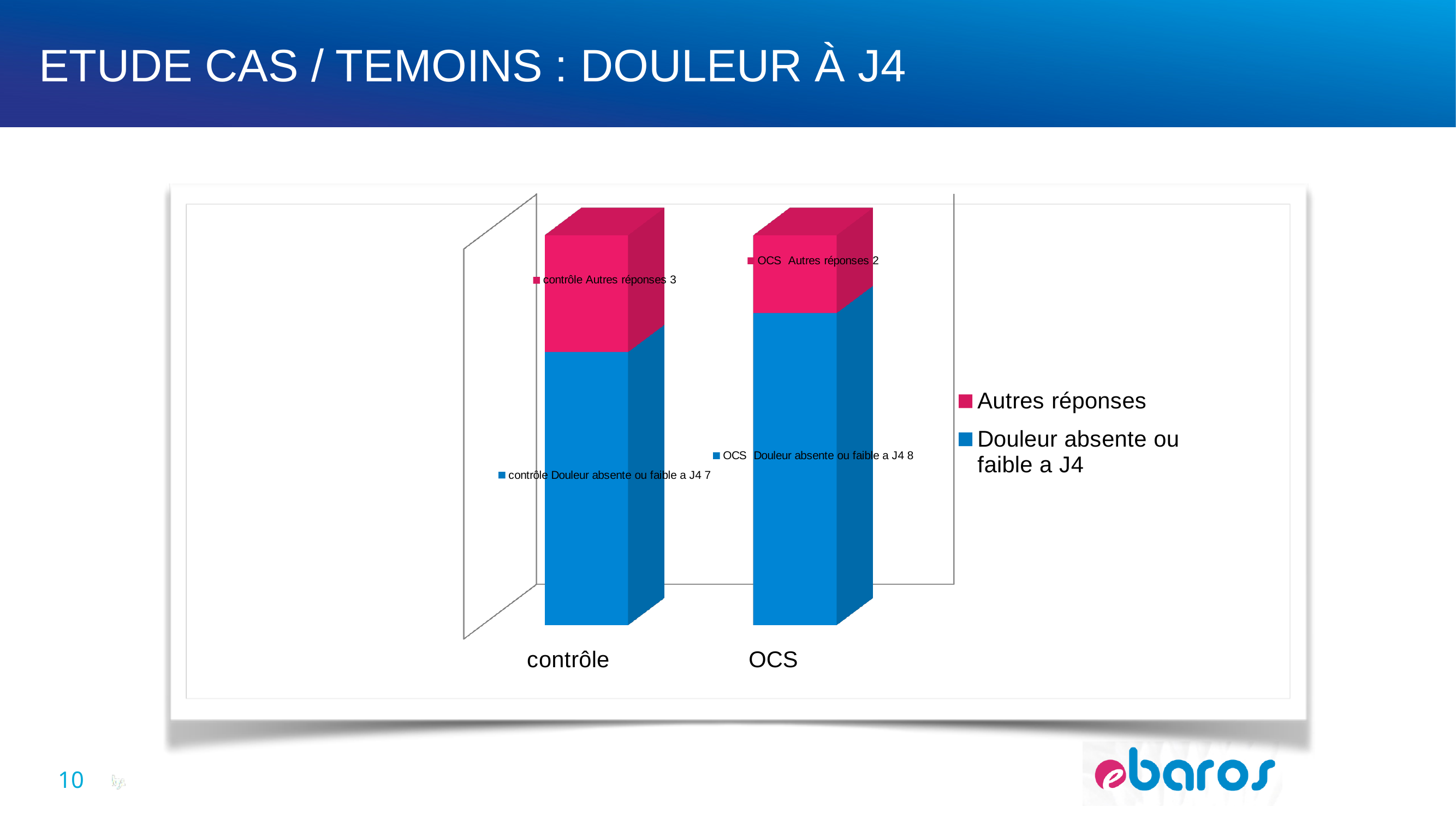
What is the value for "Douleur absente ou faible a J4" in the contrôle group? 7 What is the total of the stacked bar for the contrôle group? 10 What is the difference between the "Douleur absente ou faible a J4" values for OCS and contrôle? 1 What is the value for "Autres réponses" in the contrôle group? 3 What is the value for "Douleur absente ou faible a J4" in the OCS group? 8 What is the value for "Autres réponses" in the OCS group? 2 Which group has the higher "Douleur absente ou faible a J4" value? OCS What is the total of the stacked bar for the OCS group? 10 How many categories are shown on the x axis? 2 Which group has the larger "Autres réponses" value, contrôle or OCS? contrôle How many series does the legend list? 2 What kind of chart is shown on the slide? Stacked bar chart